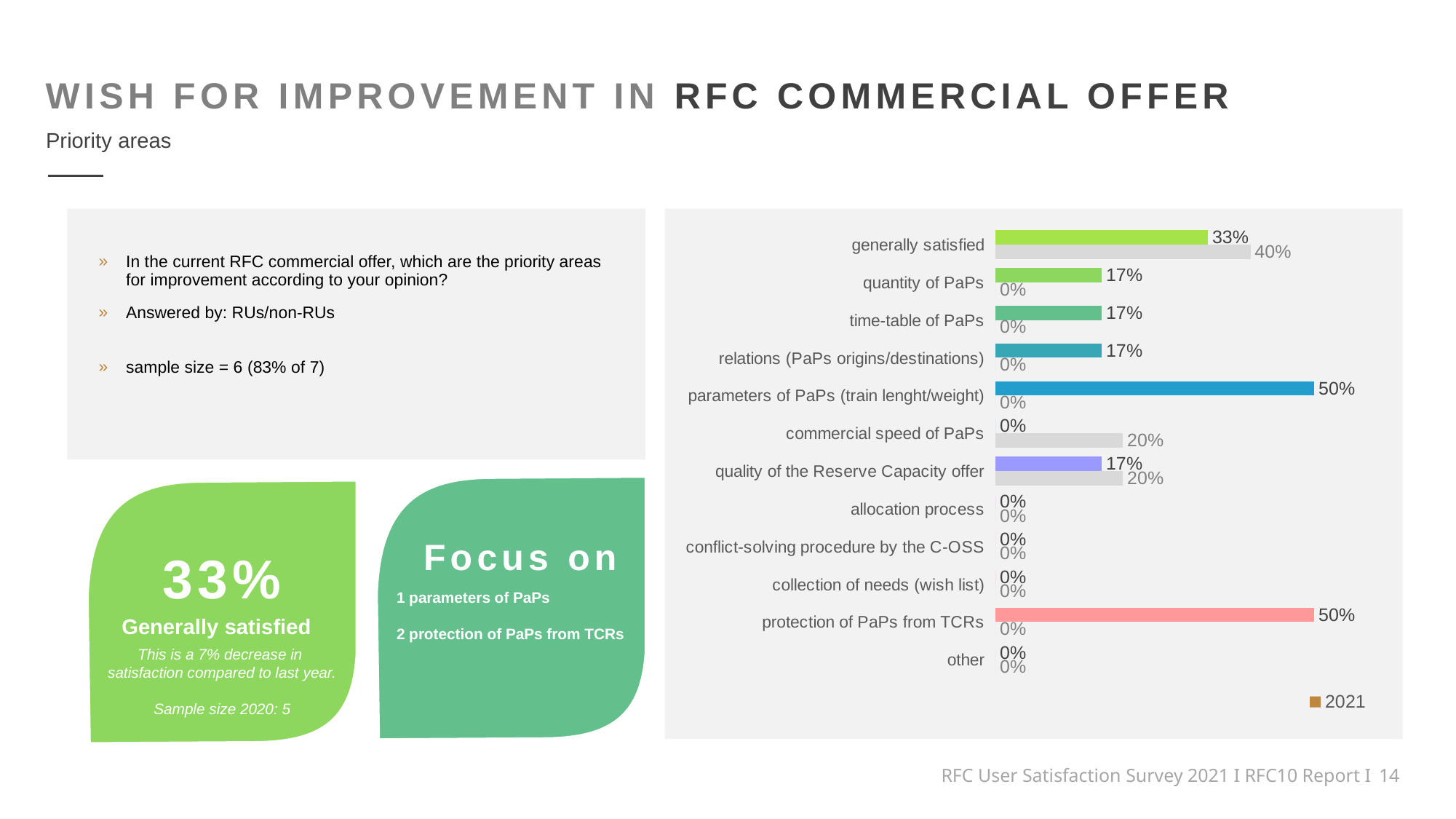
Which series name is shown in the chart legend? 2021 What is the grey (previous year) value for 'commercial speed of PaPs'? 20% What is the difference between the 2021 values for 'parameters of PaPs (train lenght/weight)' and 'quantity of PaPs'? 33% What is the difference between the grey and 2021 values for 'generally satisfied'? 7% What is the 2021 value for 'parameters of PaPs (train lenght/weight)'? 50% What is the 2021 value for 'generally satisfied'? 33% What kind of chart is shown on the slide? bar chart What is the 2021 value for 'protection of PaPs from TCRs'? 50% What is the grey (previous year) value for 'generally satisfied'? 40% How many categories are listed on the chart? 12 What is the 2021 value for 'quality of the Reserve Capacity offer'? 17% Which is larger for 'quantity of PaPs': the 2021 value or the grey value? 2021 value